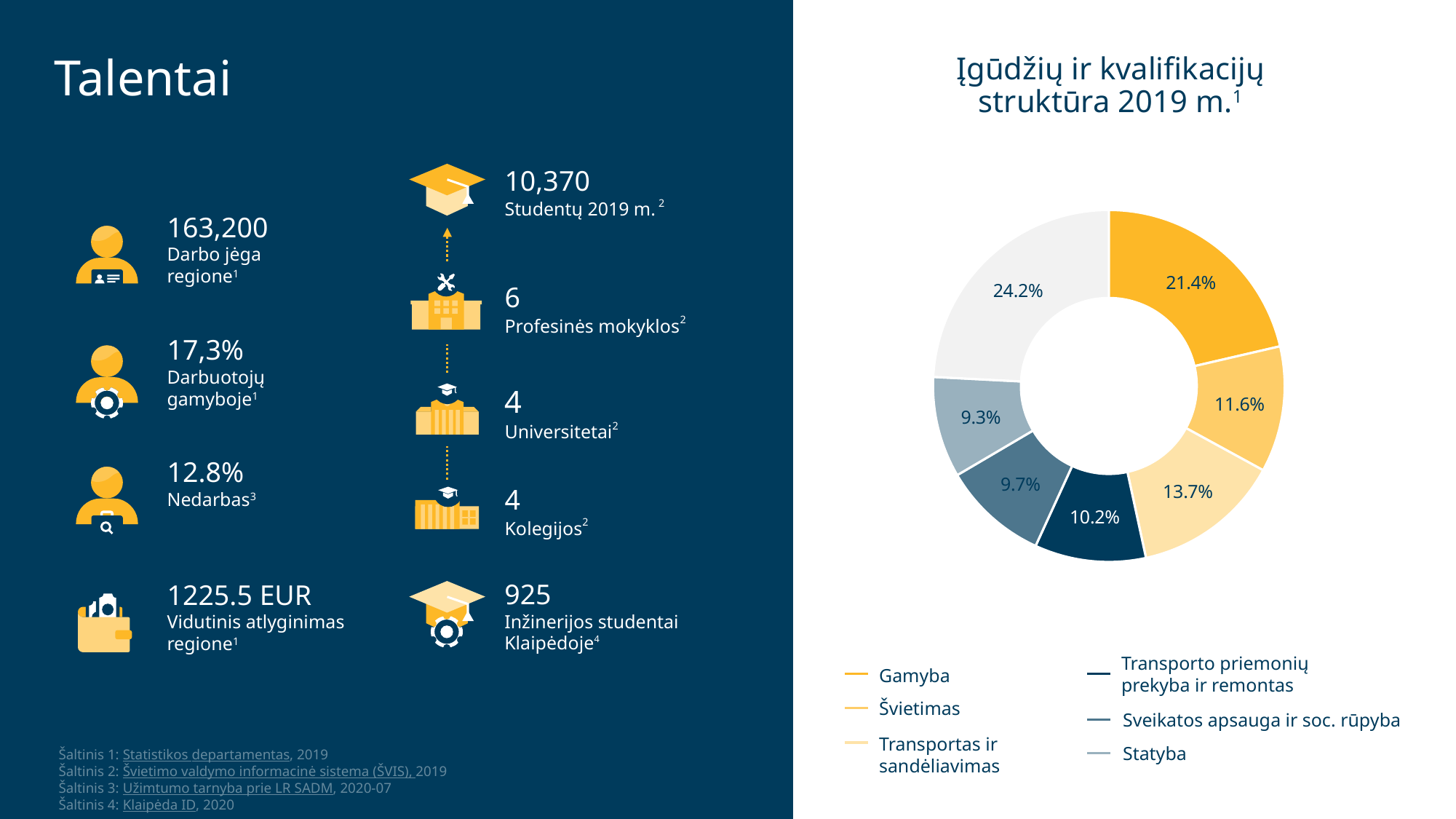
In the donut chart, what share is shown for Transporto priemonių prekyba ir remontas? 10.2% In the donut chart, how many percentage points larger is the Gamyba share than the Švietimas share? 9.8 What is the title of the chart on the right side of the slide? Įgūdžių ir kvalifikacijų struktūra 2019 m. In the donut chart, what share is shown for Transportas ir sandėliavimas? 13.7% In the donut chart, what share is shown for Švietimas? 11.6% In the donut chart, what share is shown for Sveikatos apsauga ir soc. rūpyba? 9.7% In the donut chart, which is larger: the share for Švietimas or the share for Transportas ir sandėliavimas? Transportas ir sandėliavimas Among the categories listed in the legend of the donut chart, which has the smallest share? Statyba What kind of chart is shown on the right side of the slide? Pie (donut) chart In the donut chart, what share is shown for Gamyba? 21.4% In the donut chart, what share is shown for Statyba? 9.3% How many entries does the legend of the donut chart list? 6